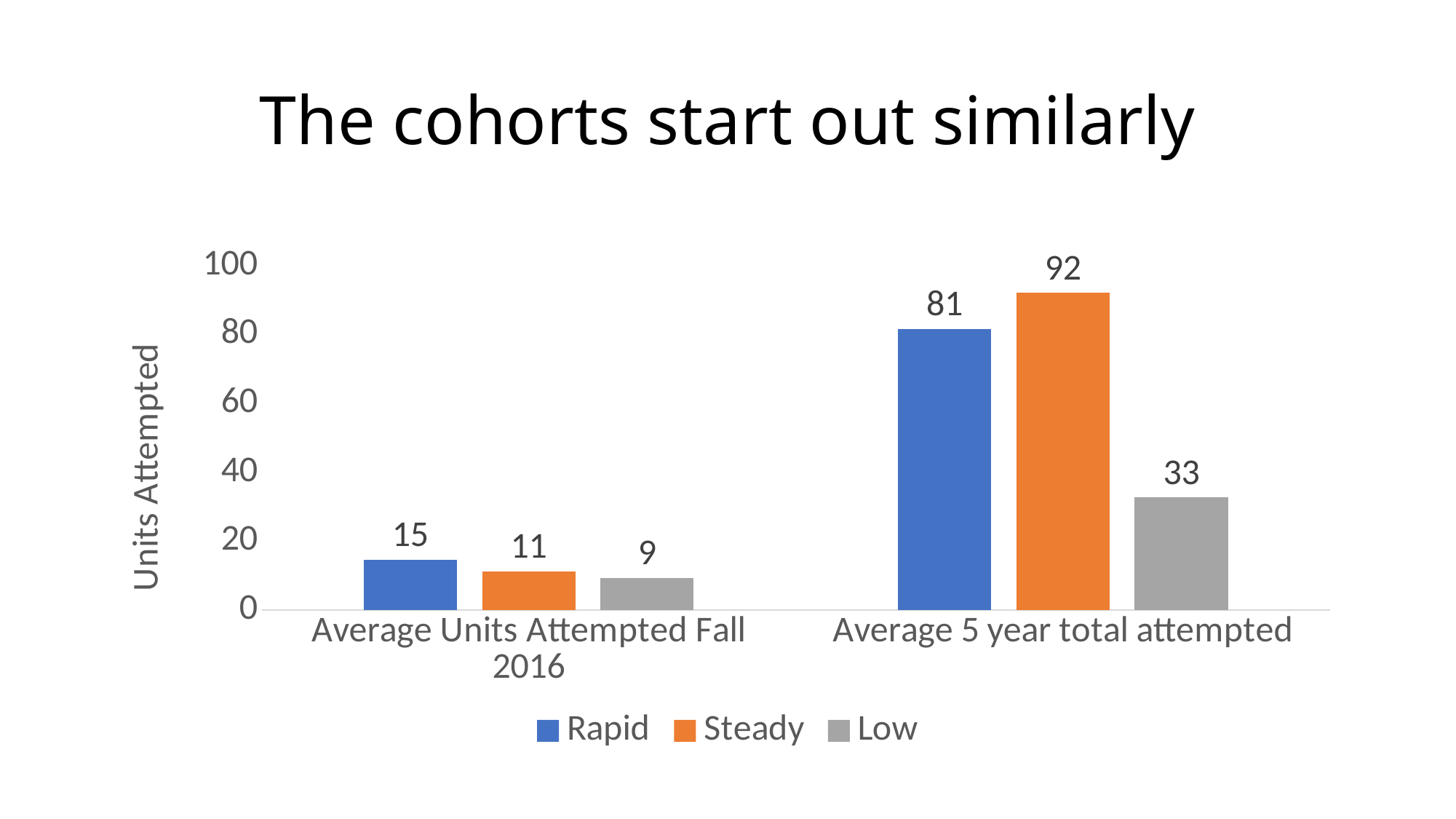
What is the value for Rapid in Average Units Attempted Fall 2016? 15 What is the value for Steady in Average 5 year total attempted? 92 What kind of chart is shown on the slide? Bar chart What is the label of the vertical axis? Units Attempted How many series does the legend list? 3 How many categories are shown on the x axis? 2 What is the difference between Steady and Low for Average 5 year total attempted? 59 Which series has the lowest value for Average 5 year total attempted? Low Which is larger for Average 5 year total attempted: Rapid or Steady? Steady What is the difference between Rapid and Steady for Average Units Attempted Fall 2016? 4 What is the value for Low in Average Units Attempted Fall 2016? 9 Which series has the highest value for Average 5 year total attempted? Steady